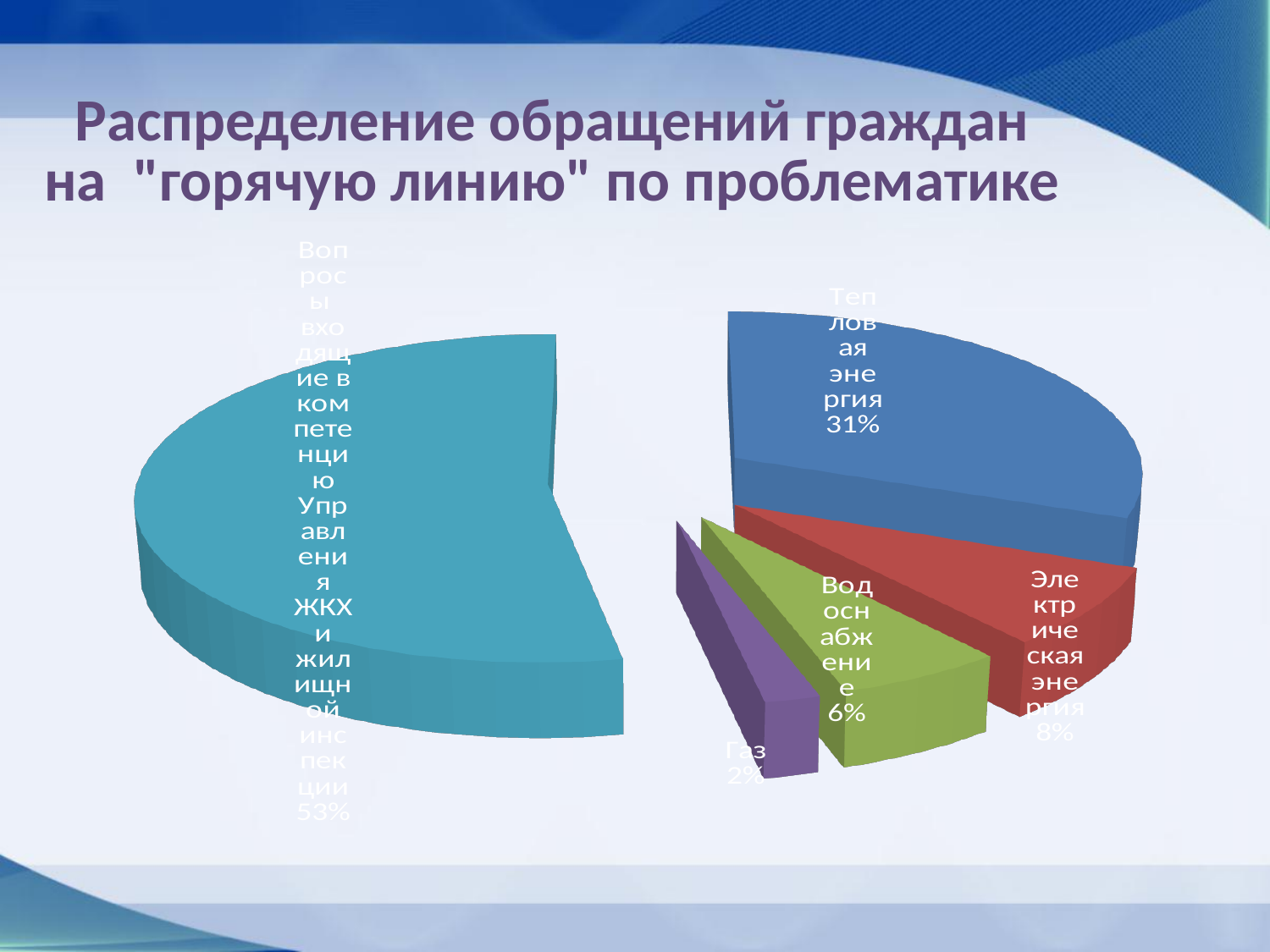
What share of the pie does "Газ" have? 2% What kind of chart is shown on the slide? Pie chart What share of the pie does "Водоснабжение" have? 6% What is the title of the slide containing the chart? Распределение обращений граждан на "горячую линию" по проблематике What share of the pie does "Тепловая энергия" have? 31% Which category has the largest slice of the pie? Вопросы входящие в компетенцию Управления ЖКХ и жилищной инспекции How many slices does the pie chart have? 5 Which is larger, the share for "Водоснабжение" or the share for "Газ"? Водоснабжение What is the difference in percentage points between "Тепловая энергия" and "Электрическая энергия"? 23 Which category has the smallest slice of the pie? Газ